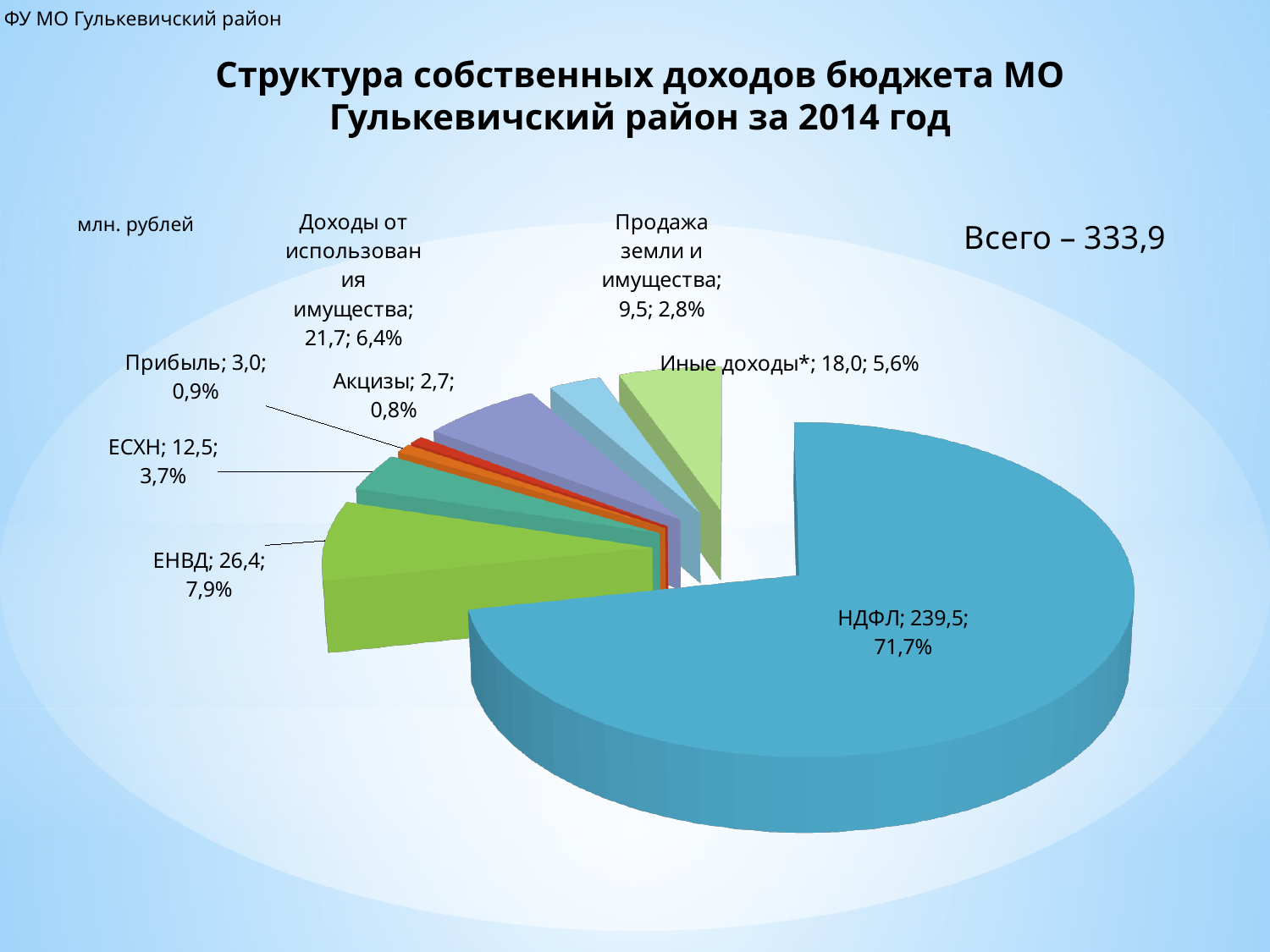
What is the value for ЕНВД? 26,4 What total (Всего) is stated on the slide for the pie chart? 333,9 What type of chart is shown on the slide? pie chart Which category has the largest slice of the pie? НДФЛ What is the value for НДФЛ in the pie chart? 239,5 What share of the pie does НДФЛ account for? 71,7% What is the value for Прибыль? 3,0 What share of the pie does Доходы от использования имущества account for? 6,4% How many slices does the pie chart have? 8 Which is larger, the value for Иные доходы* or the value for Продажа земли и имущества? Иные доходы* Which category has the smallest slice of the pie? Акцизы What is the difference between the values for ЕНВД and ЕСХН? 13,9